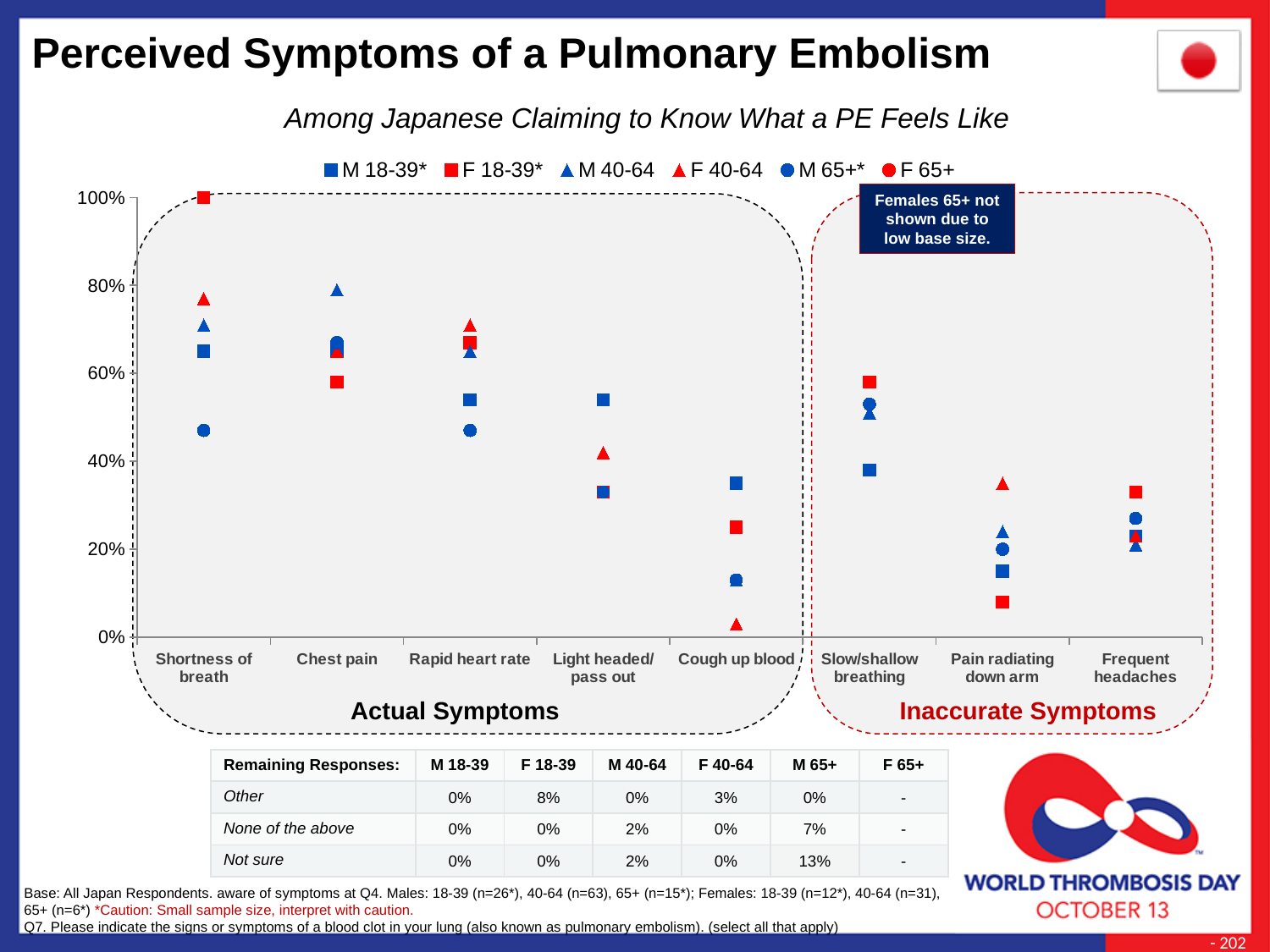
Is the value for M 65+ for Shortness of breath greater or less than 60%? less For Shortness of breath, which is larger: the value for M 18-39 or the value for M 65+? M 18-39 Which series has the lowest value for Cough up blood? F 40-64 How many symptom categories are shown on the x axis? 8 Is the value for F 18-39 for Pain radiating down arm greater or less than 20%? less What is the value for F 18-39 for Shortness of breath? 100% How many series does the legend list? 6 What kind of chart is this? Scatter (dot) chart Which series has the lowest value for Pain radiating down arm? F 18-39 Which series has the highest value for Shortness of breath? F 18-39 Which series is not shown on the chart due to low base size? Females 65+ What is the title of the chart? Perceived Symptoms of a Pulmonary Embolism